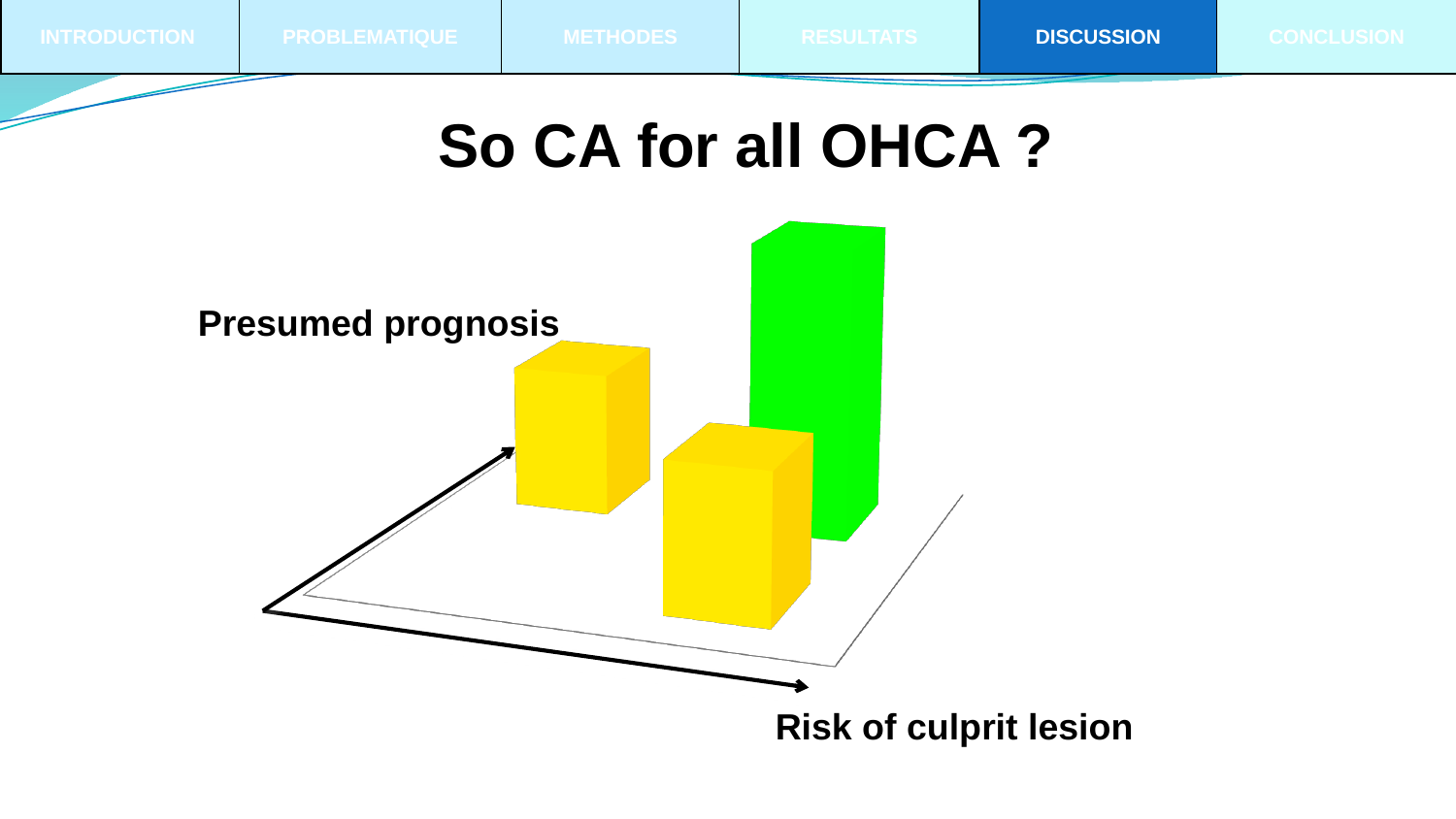
What is the label on the axis running along the bottom of the chart? Risk of culprit lesion What is the label on the axis pointing toward the back of the chart? Presumed prognosis Which colour is the tallest bar in the chart? green What kind of chart is shown on the slide? bar chart Is the green bar taller or shorter than the yellow bars? taller